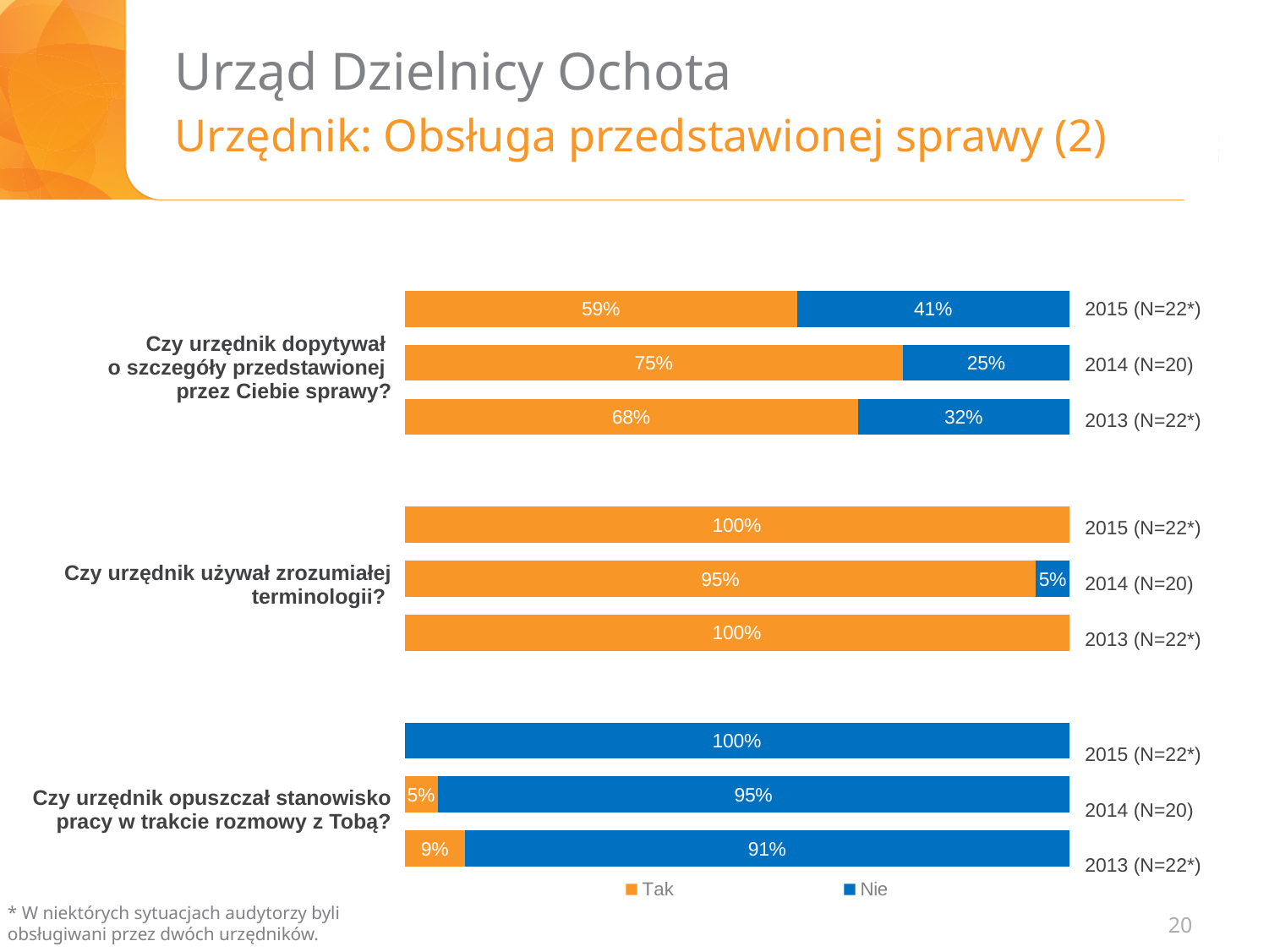
In the chart for "Czy urzędnik dopytywał o szczegóły przedstawionej przez Ciebie sprawy?", what is the "Tak" value for 2015 (N=22*)? 59% In the chart for "Czy urzędnik opuszczał stanowisko pracy w trakcie rozmowy z Tobą?", what is the "Nie" value for 2013 (N=22*)? 91% How many series does the legend list? 2 In the chart for "Czy urzędnik używał zrozumiałej terminologii?", what is the "Tak" value for 2013 (N=22*)? 100% In the chart for "Czy urzędnik dopytywał o szczegóły przedstawionej przez Ciebie sprawy?", is the "Nie" value larger for 2015 (N=22*) or 2013 (N=22*)? 2015 (N=22*) In the chart for "Czy urzędnik opuszczał stanowisko pracy w trakcie rozmowy z Tobą?", which year has the highest "Nie" value? 2015 (N=22*) In the chart for "Czy urzędnik dopytywał o szczegóły przedstawionej przez Ciebie sprawy?", what is the difference between the "Tak" values for 2014 (N=20) and 2015 (N=22*)? 16% In the chart for "Czy urzędnik używał zrozumiałej terminologii?", what is the "Nie" value for 2014 (N=20)? 5% In the chart for "Czy urzędnik dopytywał o szczegóły przedstawionej przez Ciebie sprawy?", which year has the highest "Tak" value? 2014 (N=20) In the chart for "Czy urzędnik dopytywał o szczegóły przedstawionej przez Ciebie sprawy?", what is the "Nie" value for 2013 (N=22*)? 32% What kind of chart is shown on the slide? Stacked bar chart In the chart for "Czy urzędnik opuszczał stanowisko pracy w trakcie rozmowy z Tobą?", what is the "Tak" value for 2014 (N=20)? 5%